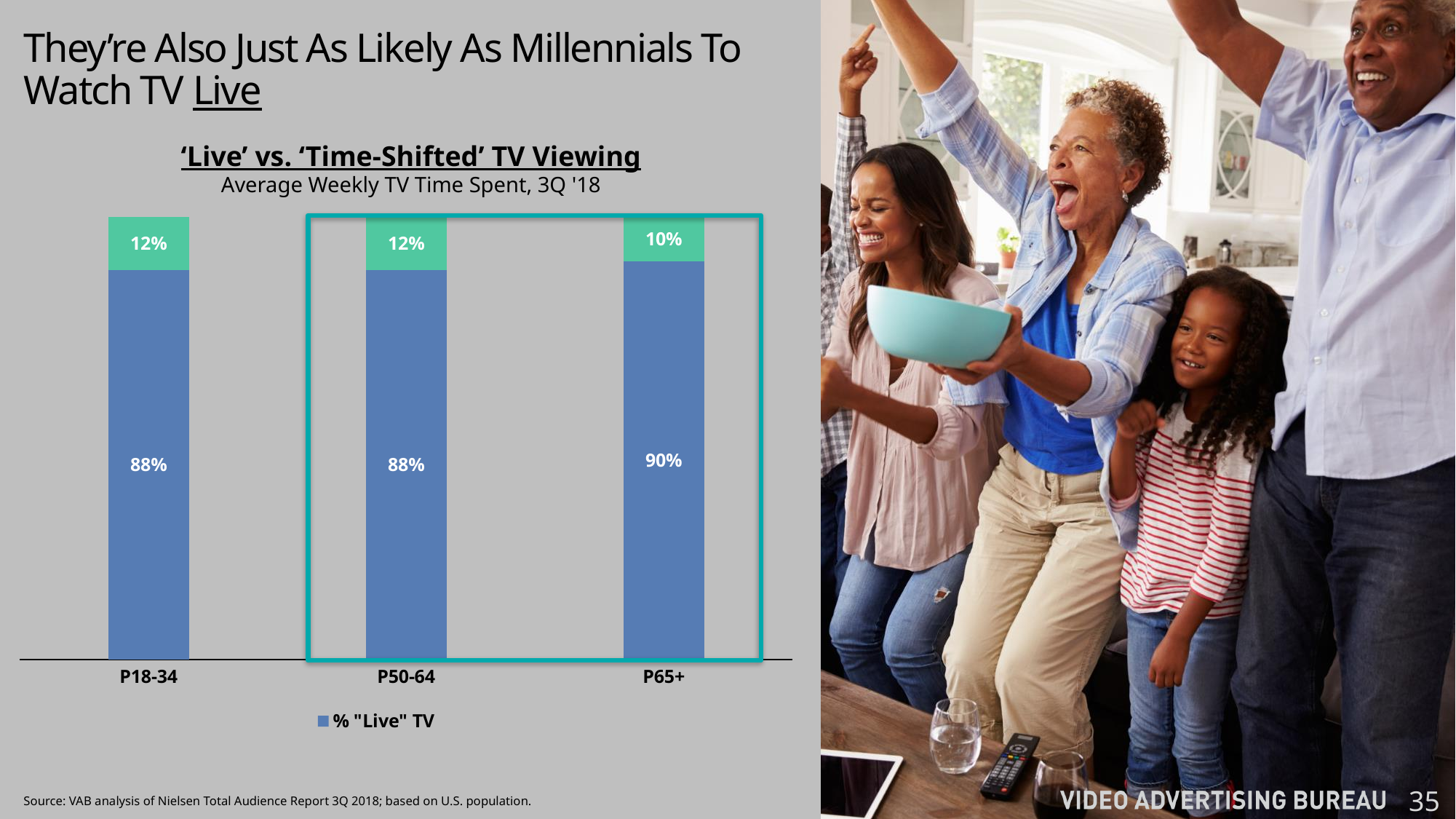
How many age groups are shown on the x axis? 3 What is the total of the stacked bar for P18-34? 100% Is the % "Live" TV value larger for P50-64 or for P65+? P65+ What is the % "Live" TV value for P18-34? 88% What is the % "Live" TV value for P65+? 90% What kind of chart is shown on the slide? Stacked bar chart What is the value of the green (top) segment for P50-64? 12% How many series does the legend list? 1 Which age group has the lowest green (top) segment value? P65+ Which age group has the highest % "Live" TV value? P65+ What is the difference between the % "Live" TV values for P65+ and P18-34? 2% What is the value of the green (top) segment for P65+? 10%